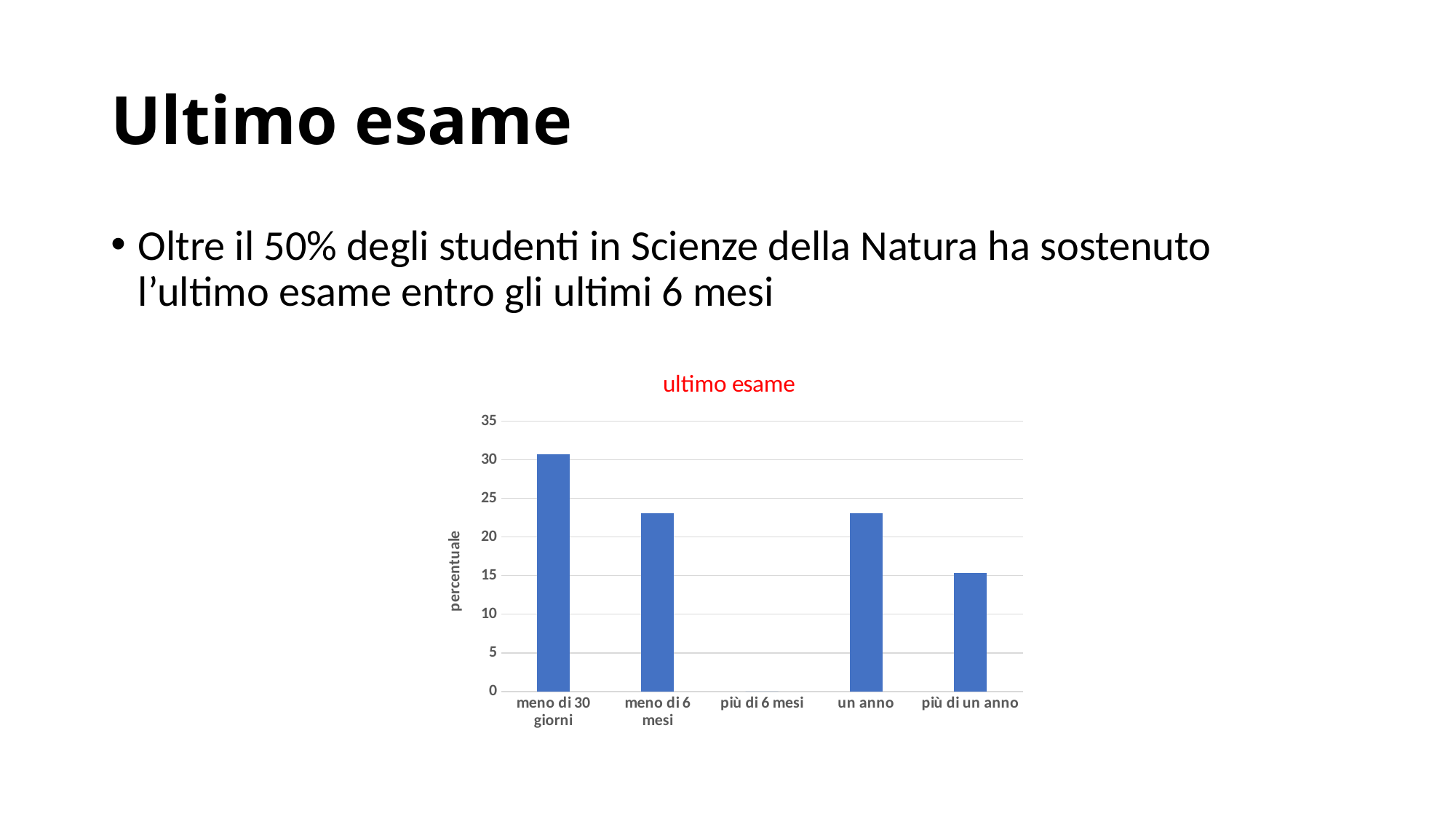
What is the label on the vertical axis of the chart? percentuale How many categories are shown on the x axis of the chart? 5 Which category has no visible bar in the chart? più di 6 mesi Which is larger, the value for 'un anno' or the value for 'più di un anno'? un anno Is the value for 'meno di 30 giorni' greater or less than 25? greater Is the value for 'un anno' greater or less than 20? greater Which category has the highest bar in the chart? meno di 30 giorni Among the categories with a visible bar, which one has the lowest value? più di un anno Is the value for 'più di un anno' greater or less than 20? less Which is larger, the value for 'meno di 30 giorni' or the value for 'un anno'? meno di 30 giorni What kind of chart is shown on the slide? bar chart